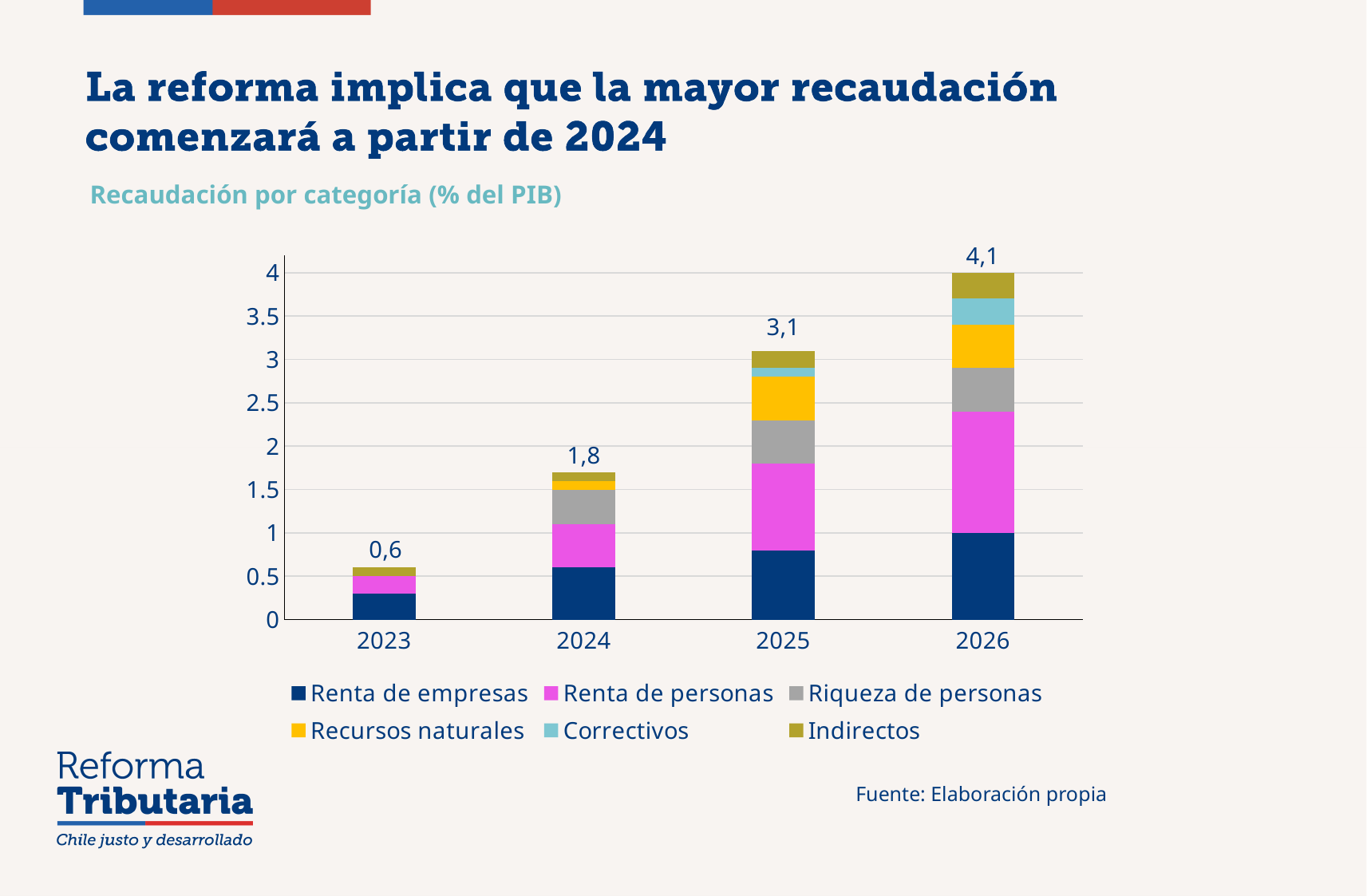
Which year has the lowest total recaudación? 2023 How many years are shown on the x axis? 4 Which is larger, the total for 2025 or the total for 2024? 2025 What is the total value labelled above the 2024 bar? 1,8 What is the total value labelled above the 2023 bar? 0,6 Is the total for 2024 greater or less than 2? less What is the difference between the total for 2025 and the total for 2024? 1,3 What is the total recaudación shown for 2026? 4,1 How many series does the legend list? 6 Which year has the highest total recaudación? 2026 What kind of chart is shown on the slide? stacked bar chart What is the difference between the total for 2026 and the total for 2023? 3,5